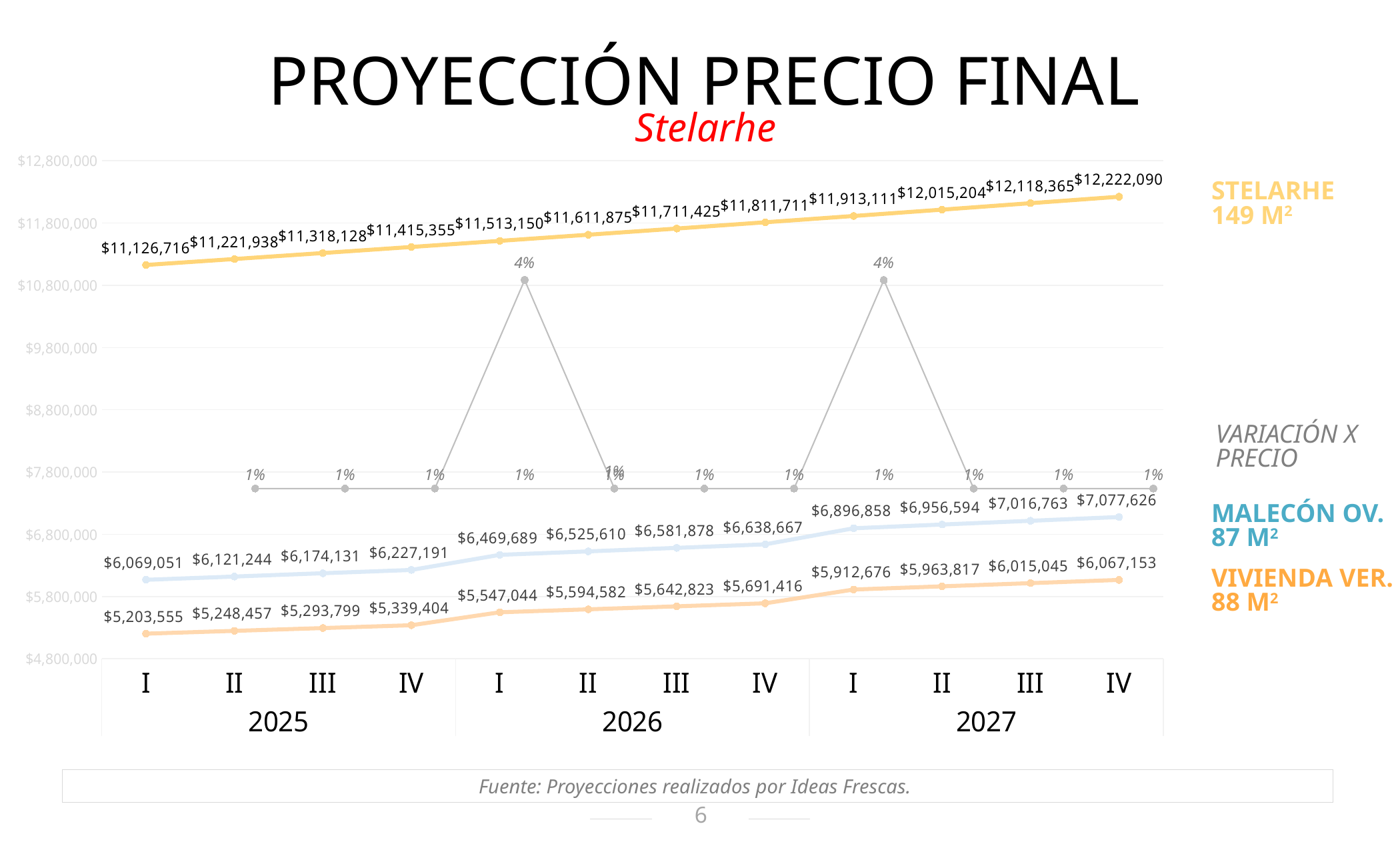
What is the projected price for Malecón Ov. in quarter I of 2026? $6,469,689 What kind of chart is shown on the slide? Line chart Which series has the highest projected prices throughout the chart? Stelarhe What is the projected price for Stelarhe in quarter IV of 2027? $12,222,090 In quarter I of 2025, which is larger: the Malecón Ov. price or the Vivienda Ver. price? Malecón Ov. By how much does the Stelarhe price in quarter IV of 2027 exceed its price in quarter I of 2025? $1,095,374 What is the Variación x precio value shown for quarter I of 2026? 4% Do the Stelarhe prices rise or fall from 2025 to 2027? Rise How many quarterly points are plotted along the x axis? 12 What is the projected price for Vivienda Ver. in quarter IV of 2027? $6,067,153 What is the difference between the Malecón Ov. and Vivienda Ver. prices in quarter IV of 2027? $1,010,473 What is the projected price for Stelarhe in quarter I of 2025? $11,126,716